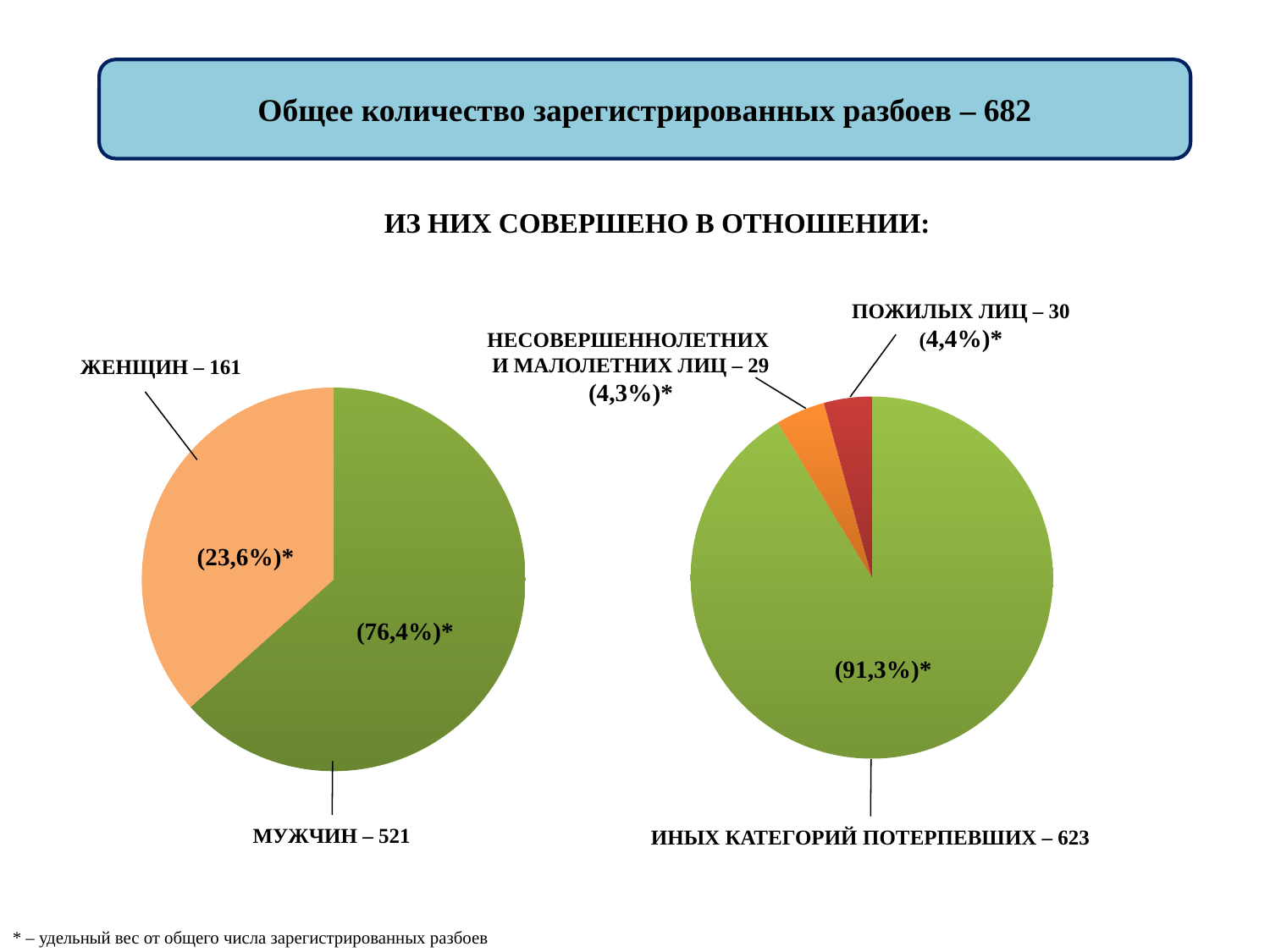
In the left pie chart, what is the value for ЖЕНЩИН? 161 In the right pie chart, what share of the pie does the ИНЫХ КАТЕГОРИЙ ПОТЕРПЕВШИХ slice represent? 91,3% In the left pie chart, which is larger, the value for ЖЕНЩИН or the value for МУЖЧИН? МУЖЧИН How many slices does the right pie chart have? 3 In the left pie chart, what is the difference between the values for МУЖЧИН and ЖЕНЩИН? 360 What kind of chart is the left chart on the slide? pie chart In the right pie chart, what is the value for ПОЖИЛЫХ ЛИЦ? 30 In the right pie chart, what is the value for НЕСОВЕРШЕННОЛЕТНИХ И МАЛОЛЕТНИХ ЛИЦ? 29 What total number of registered robberies is stated in the box at the top of the slide? 682 In the right pie chart, which category has the largest value? ИНЫХ КАТЕГОРИЙ ПОТЕРПЕВШИХ In the left pie chart, what share of the pie does the МУЖЧИН slice represent? 76,4% In the left pie chart, what is the value for МУЖЧИН? 521